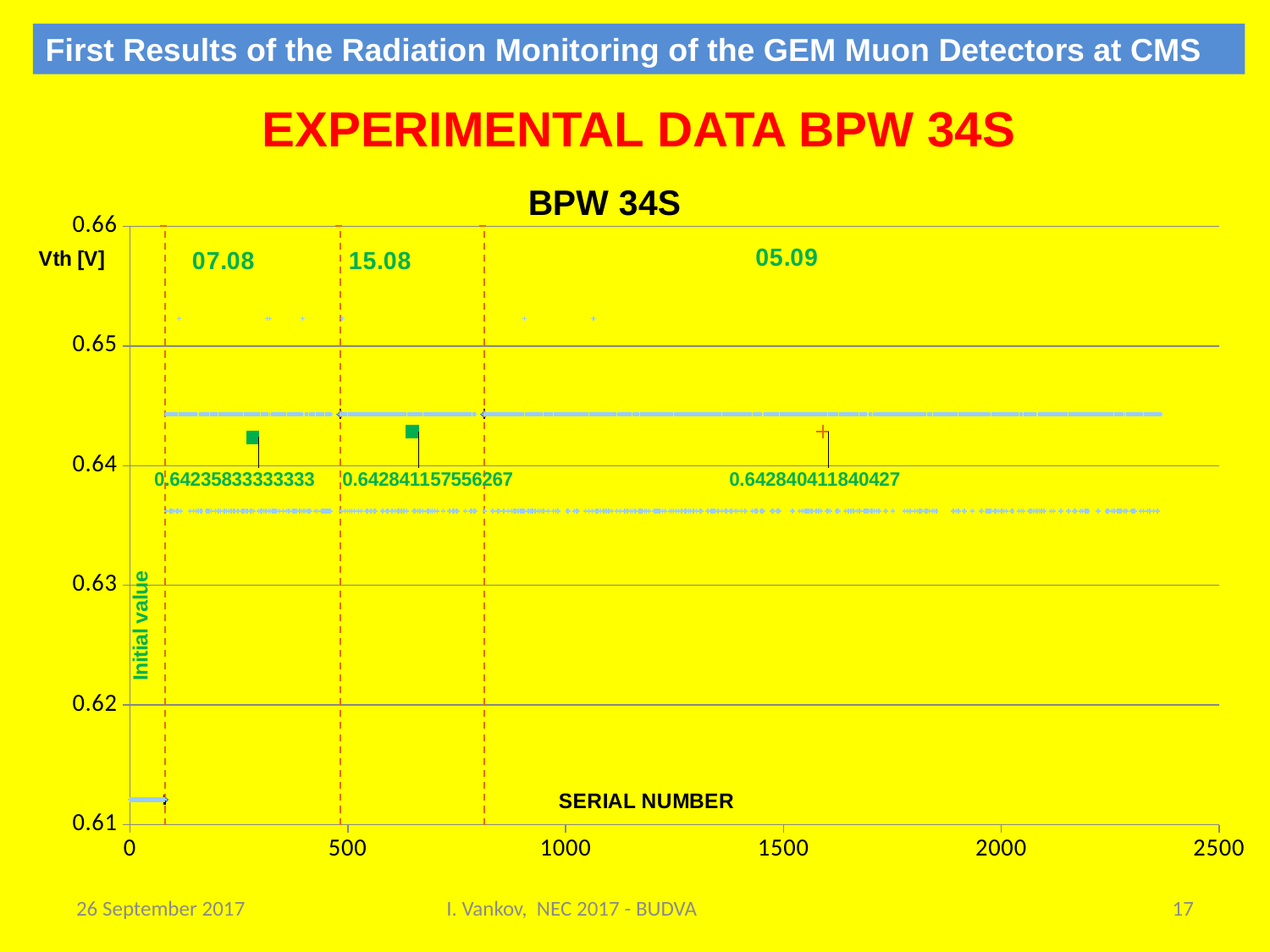
What is the highest value shown on the x axis (SERIAL NUMBER)? 2500 What label is written next to the first vertical dashed line on the chart? Initial value What value is printed for the 07.08 period on the chart? 0.64235833333333 What kind of chart is shown on the slide? scatter chart What is the title of the chart? BPW 34S Is the lower horizontal band of data points greater or less than 0.64? less Is the upper horizontal band of data points greater or less than 0.64? greater Which of the three dated periods has the lowest printed value? 07.08 Which printed value is larger, the one for 07.08 or the one for 15.08? 15.08 What value is printed for the 15.08 period on the chart? 0.642841157556267 How many dated periods are marked on the chart? 3 What value is printed for the 05.09 period on the chart? 0.642840411840427